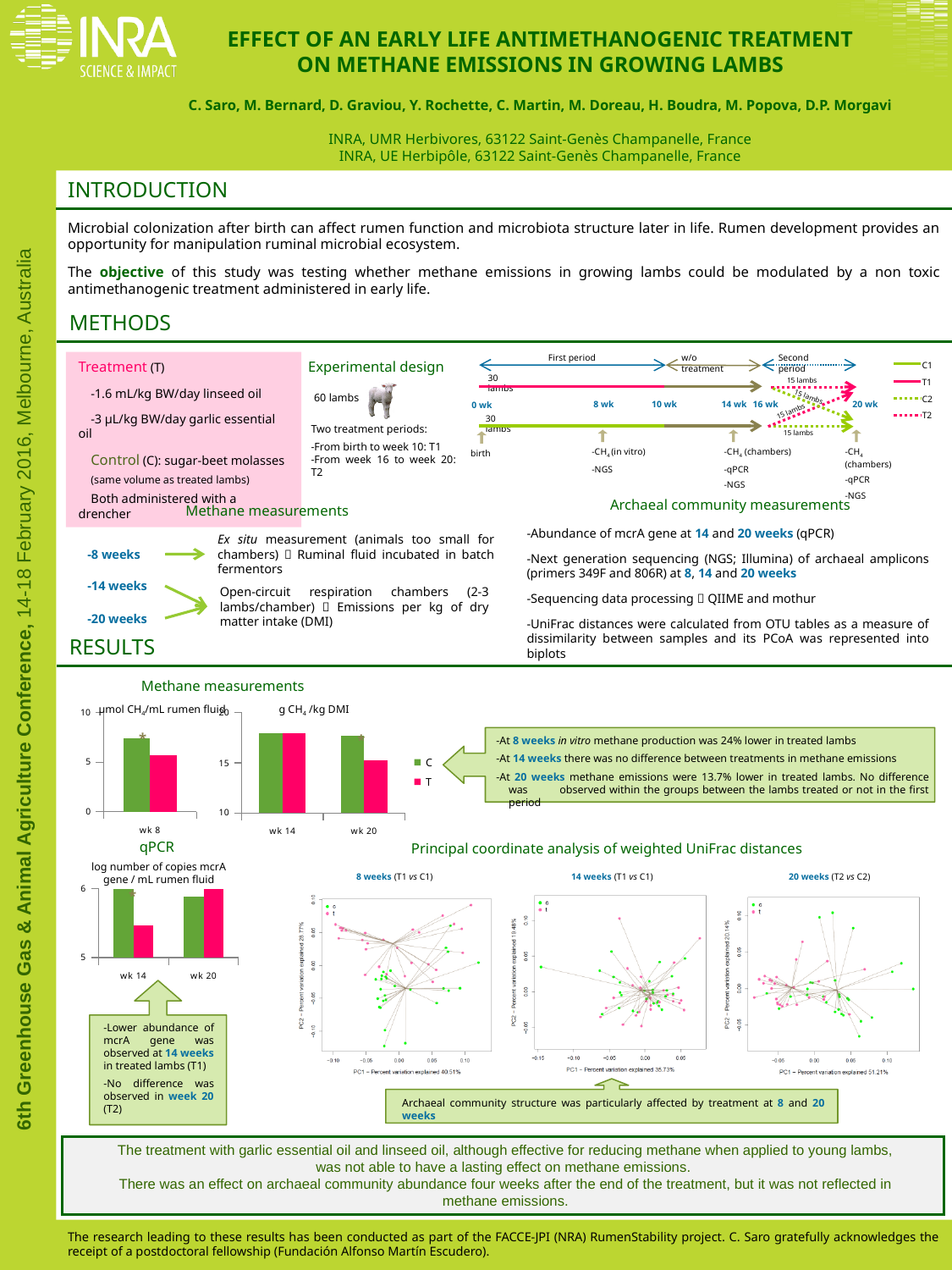
In the "g CH4/kg DMI" chart, is the value for C at wk 14 greater or less than 15? greater In the "µmol CH4/mL rumen fluid" chart, is the value for C at wk 8 greater or less than 5? greater In the "µmol CH4/mL rumen fluid" chart, which is larger at wk 8, C or T? C In the qPCR chart (log number of copies mcrA gene / mL rumen fluid), which is larger at wk 14, C or T? C How many scatter plots are shown under "Principal coordinate analysis of weighted UniFrac distances"? 3 In the "g CH4/kg DMI" chart, does the value for T rise or fall from wk 14 to wk 20? fall What kind of chart is the "µmol CH4/mL rumen fluid" chart? bar chart In the legend next to the "g CH4/kg DMI" chart, which series is shown in pink? T In the qPCR chart (log number of copies mcrA gene / mL rumen fluid), is the value for T at wk 14 greater or less than 6? less How many categories are shown on the x axis of the "g CH4/kg DMI" chart? 2 How many series does the legend next to the "g CH4/kg DMI" chart list? 2 In the "g CH4/kg DMI" chart, which is larger at wk 20, C or T? C